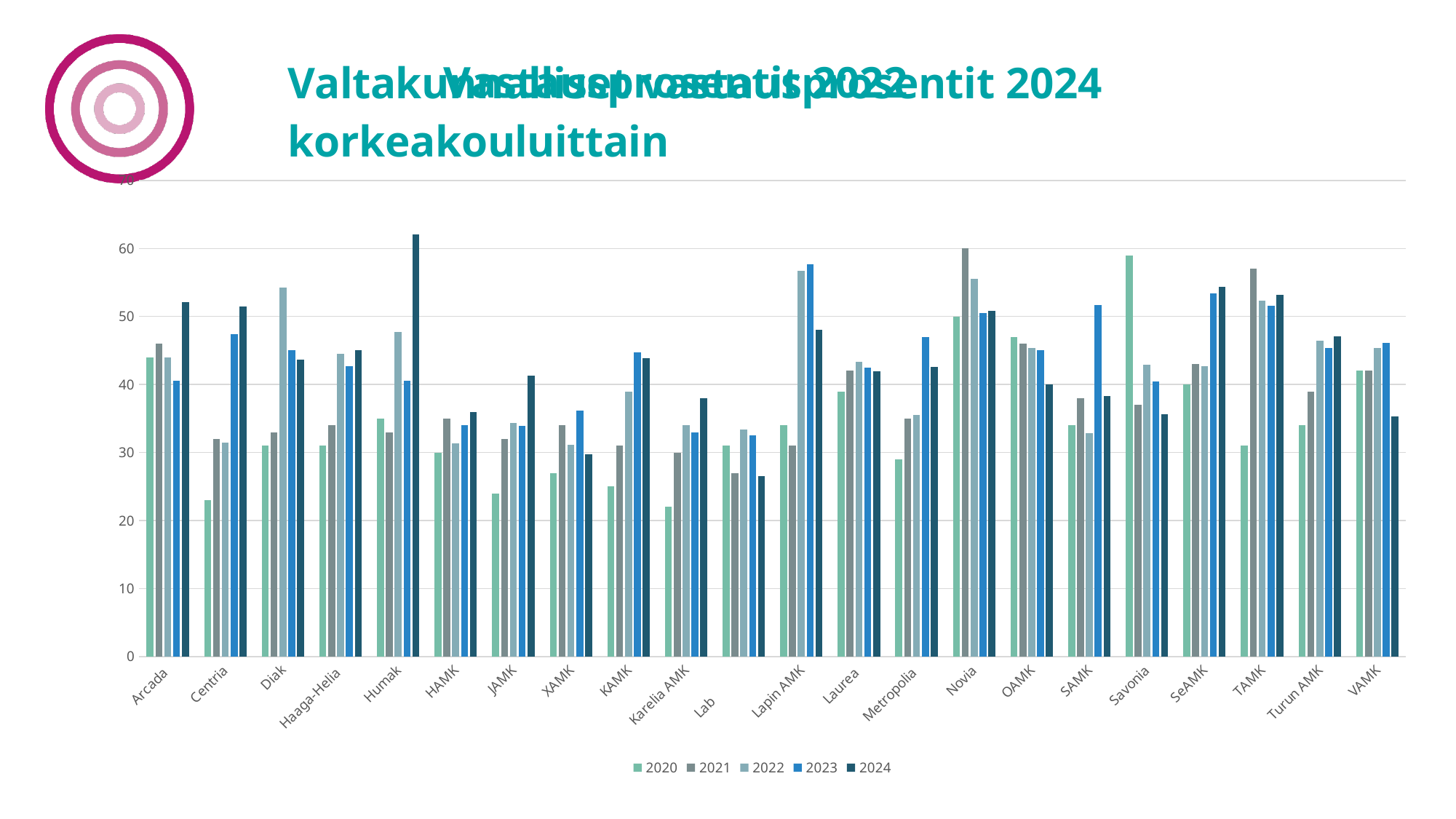
Which years are listed in the legend? 2020, 2021, 2022, 2023, 2024 Is the 2020 value for Centria greater or less than 30? less What kind of chart is shown on the slide? bar chart How many series does the legend list? 5 Is the 2024 value for Lab greater or less than 30? less For Centria, is the 2024 value higher or lower than the 2020 value? higher For Humak, which is larger: the 2020 value or the 2024 value? 2024 Is the 2023 value for Lapin AMK greater or less than 50? greater How many institutions (categories) are shown on the x axis? 22 Which institution has the highest 2024 value? Humak